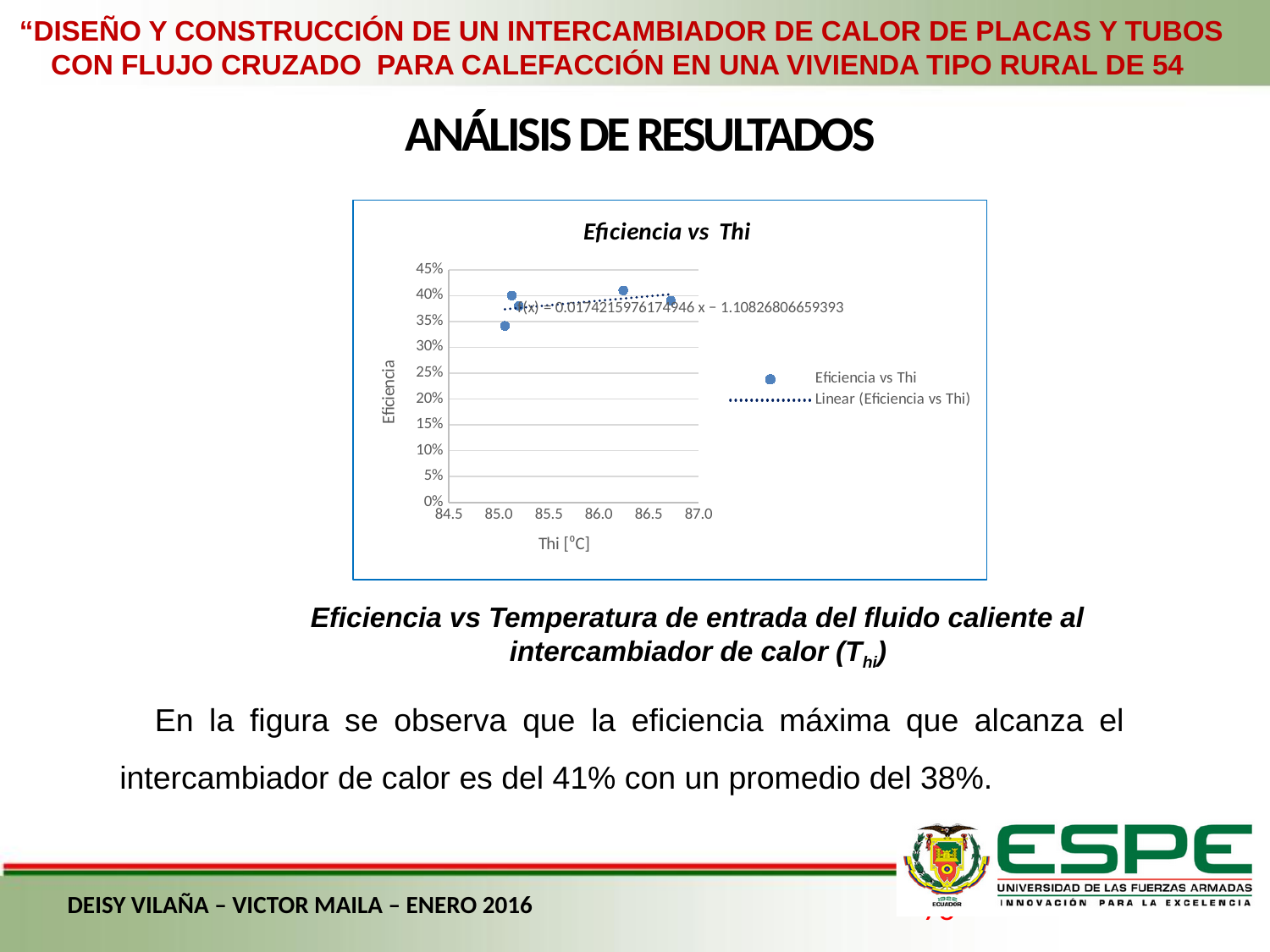
What is the highest value shown on the y axis of the chart? 45% What is the slope of the linear trend line equation shown on the chart? 0.0174215976174946 What is the label of the x axis of the chart? Thi [°C] Is the efficiency of the lowest point on the chart greater or less than 25%? greater What is the lowest value shown on the x axis of the chart? 84.5 According to the linear trend line, does efficiency rise or fall as Thi increases? rise Is the efficiency of the highest point on the chart greater or less than 35%? greater What is the title of the chart? Eficiencia vs Thi What kind of chart is shown on the slide? Scatter chart Is the efficiency of the lowest point on the chart greater or less than 40%? less How many entries does the chart legend list? 2